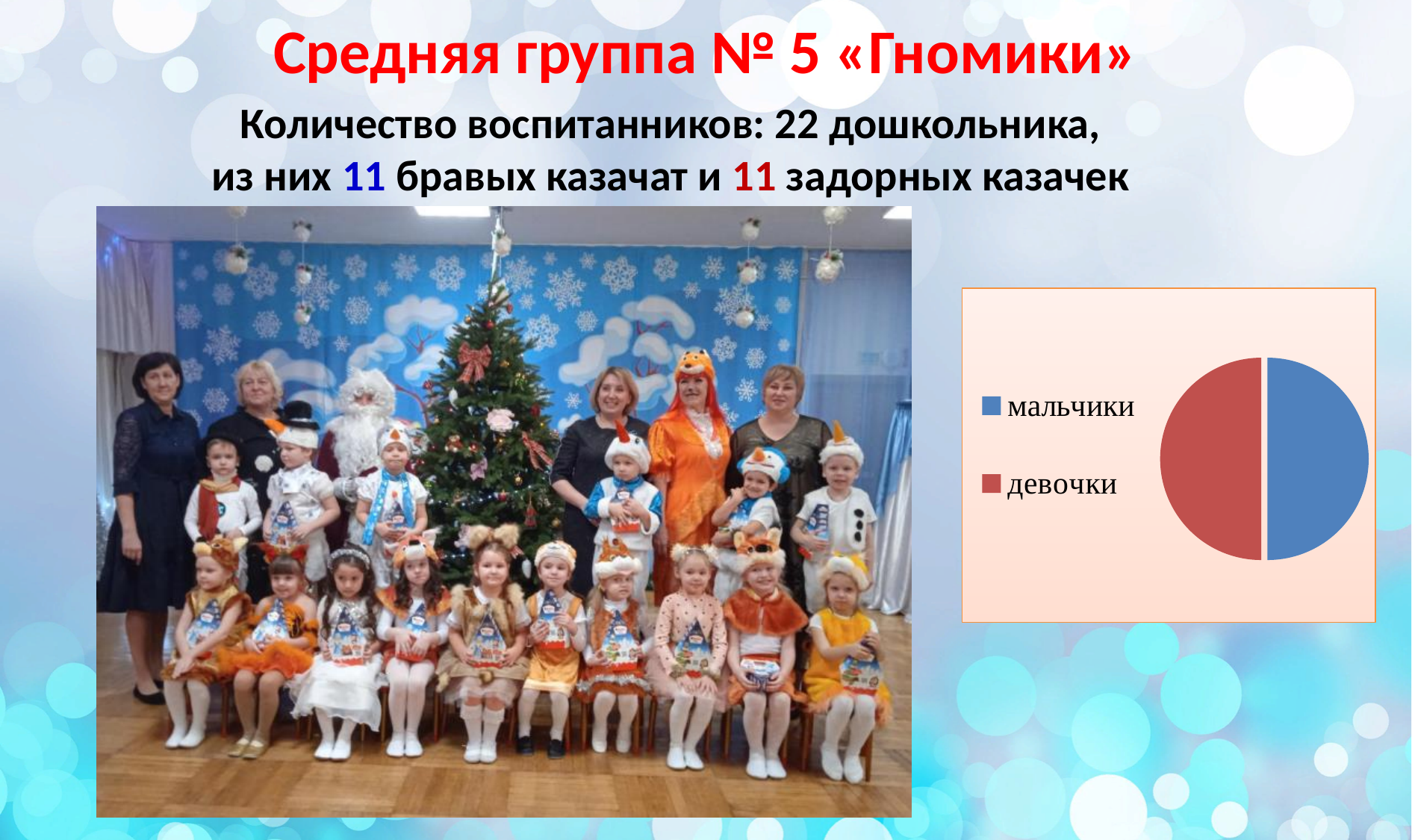
According to the slide text, how many девочки (girls) are in the group shown in the pie chart? 11 What is the difference between the number of мальчики and девочки shown on the slide? 0 According to the slide text, how many мальчики (boys) are in the group shown in the pie chart? 11 Which legend entry is shown in blue in the pie chart? мальчики How many slices does the pie chart have? 2 How many entries does the legend of the pie chart list? 2 What is the total number of children represented by the pie chart, as stated on the slide? 22 Which legend entry is shown in red in the pie chart? девочки What kind of chart is shown on the slide? pie chart